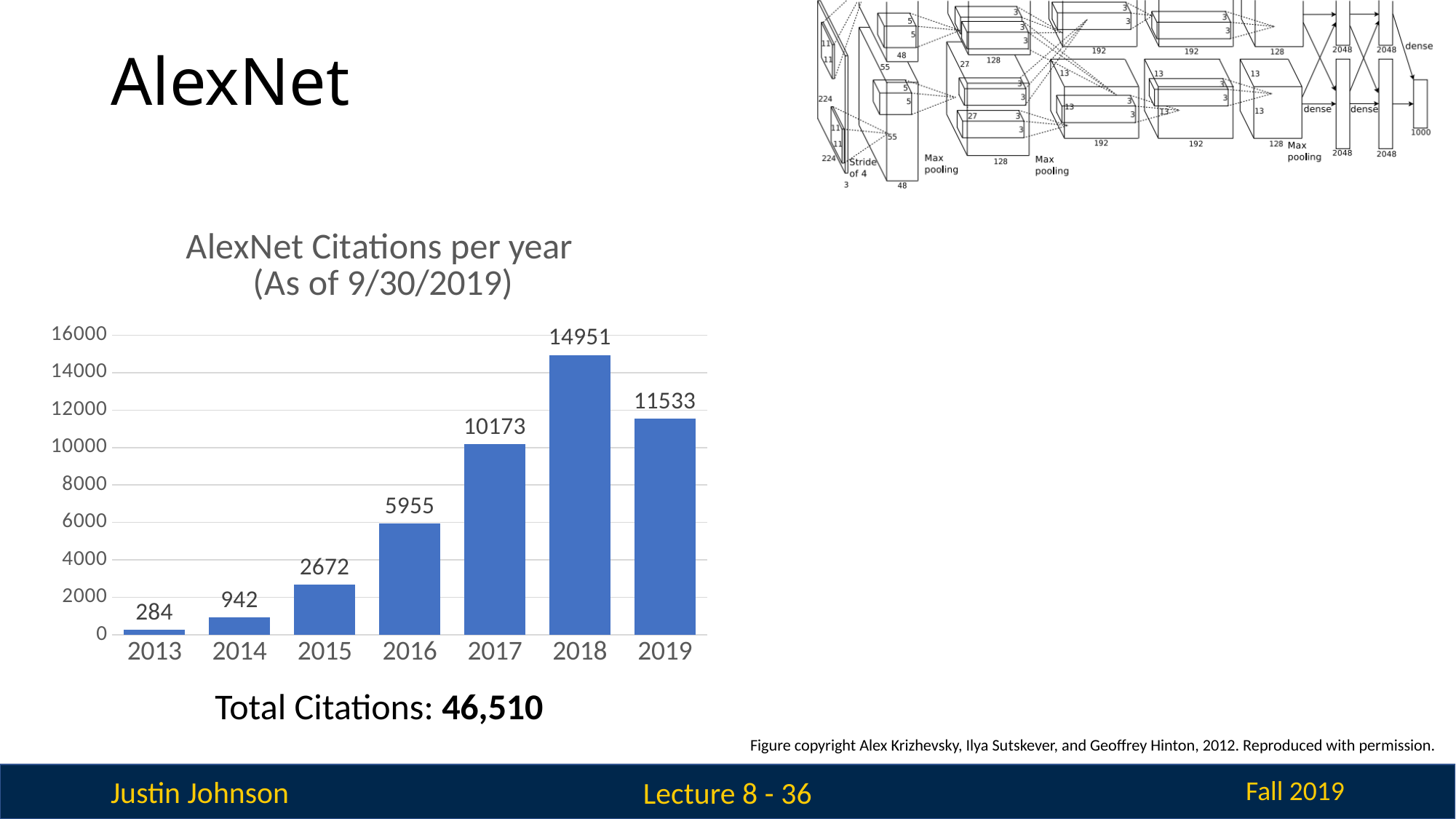
What is the number of citations for 2016? 5955 What is the title of the chart? AlexNet Citations per year (As of 9/30/2019) What is the difference in citations between 2017 and 2016? 4218 How many years are shown on the x axis? 7 What is the number of citations for 2013? 284 Is the value for 2015 greater or less than 4000? less Which year has the highest number of citations? 2018 What kind of chart is shown on the slide? bar chart Which year has more citations, 2017 or 2019? 2019 Which year has the lowest number of citations? 2013 What is the number of citations for 2018? 14951 What is the difference in citations between 2018 and 2019? 3418